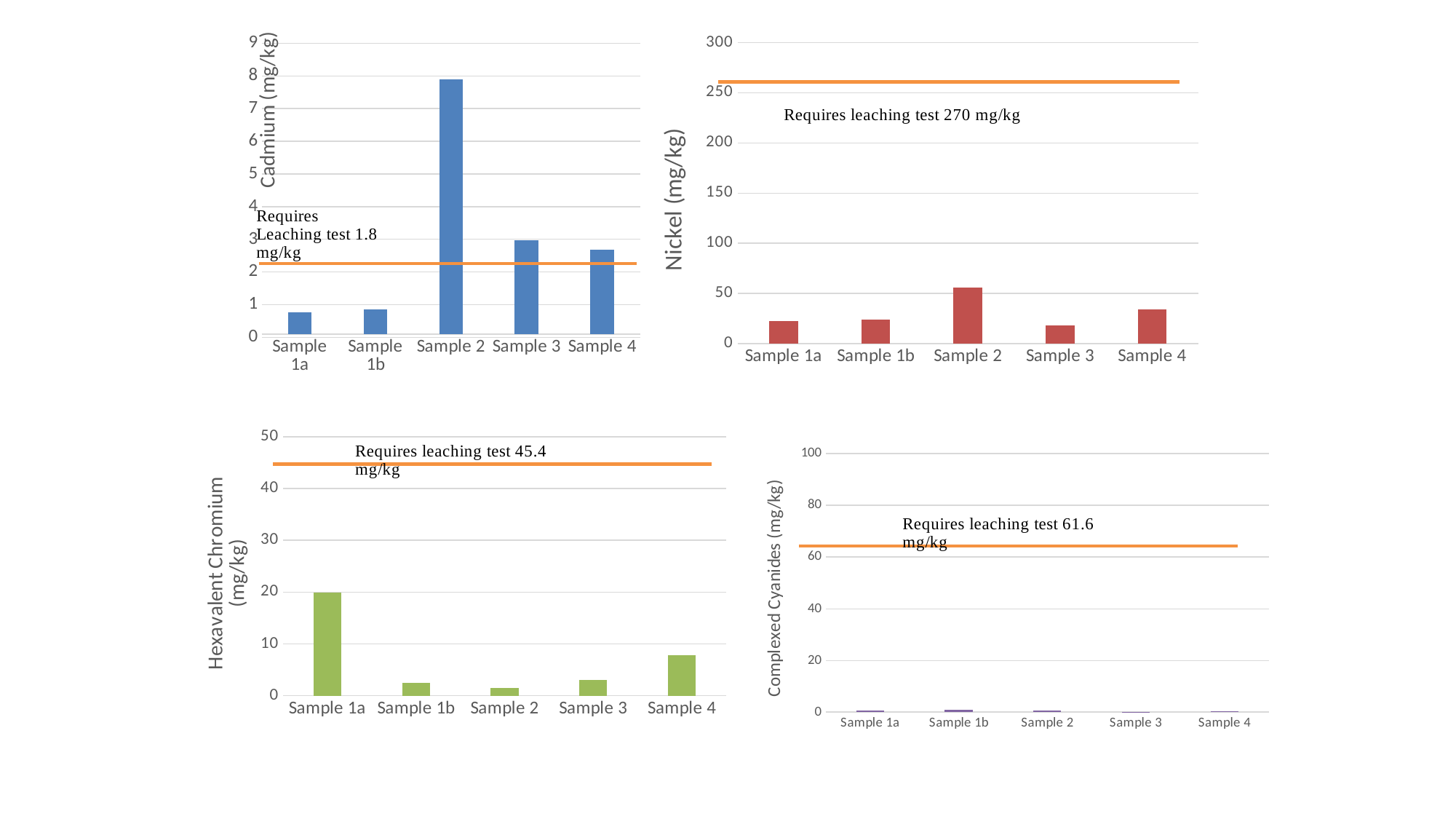
In the Nickel chart, is the value for Sample 2 greater or less than 50? greater In the Hexavalent Chromium chart, is the value for Sample 4 greater or less than 10? less In the Nickel chart, which sample has the lowest nickel value? Sample 3 In the Nickel chart, which sample has the highest nickel value? Sample 2 In the Cadmium chart, which sample has the highest cadmium value? Sample 2 In the Cadmium chart, is the value for Sample 1a greater or less than 1? less How many samples are plotted in the Complexed Cyanides chart? 5 According to the Nickel chart, at what concentration is a leaching test required? 270 mg/kg What kind of chart is the Nickel chart? bar chart In the Hexavalent Chromium chart, which sample has the highest value? Sample 1a In the Nickel chart, which is larger, the value for Sample 4 or the value for Sample 1a? Sample 4